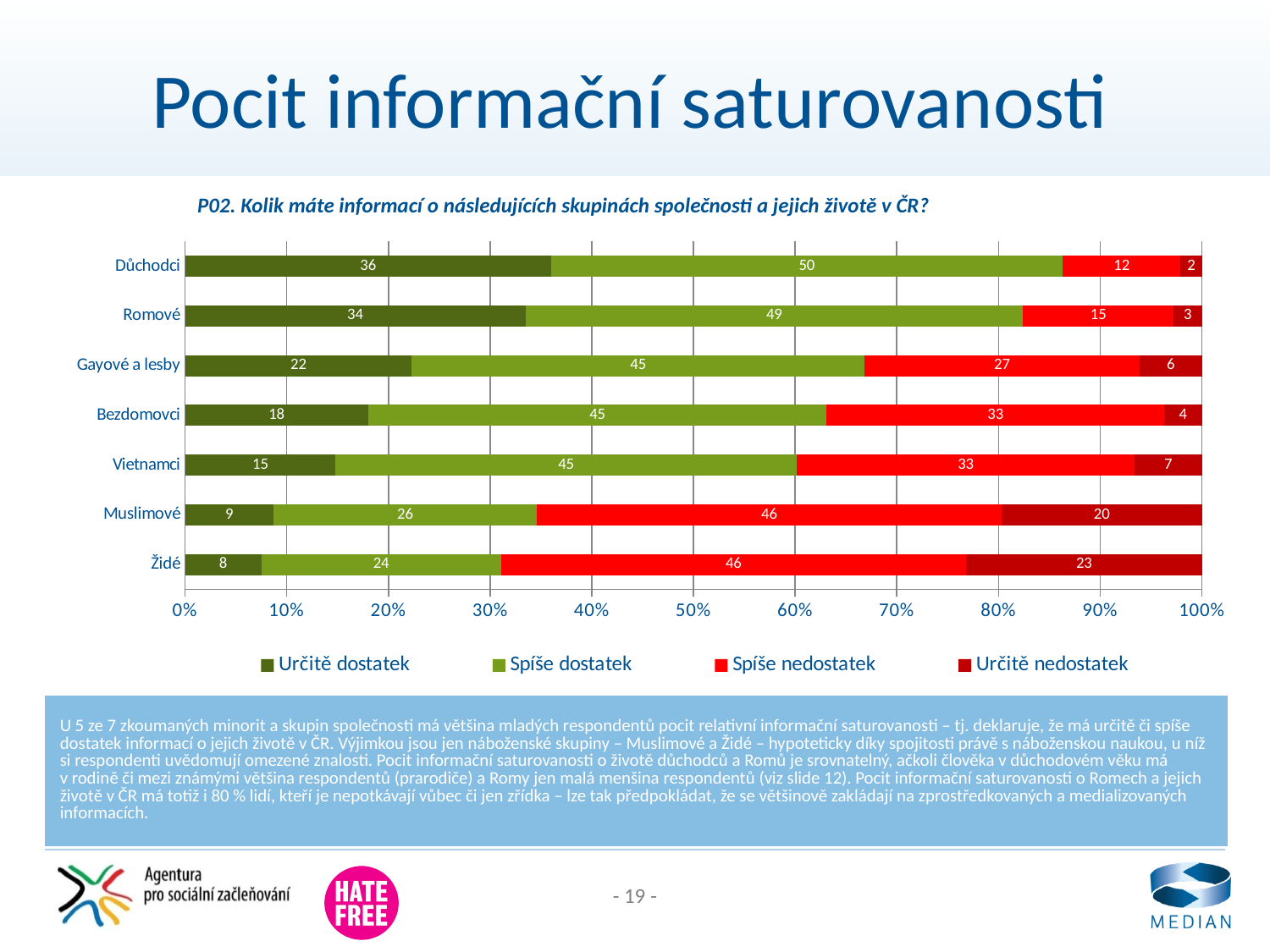
What is the value of 'Určitě dostatek' for Důchodci? 36 What is the value of 'Spíše nedostatek' for Muslimové? 46 Which group has the lowest value for 'Určitě dostatek'? Židé Which group has the highest value for 'Určitě dostatek'? Důchodci What type of chart is shown on the slide? stacked bar chart How many groups (categories) are listed on the vertical axis of the chart? 7 Which is larger: the 'Spíše nedostatek' value for Gayové a lesby or for Romové? Gayové a lesby What is the difference between the 'Spíše dostatek' values for Důchodci and Židé? 26 What is the combined value of 'Určitě dostatek' and 'Spíše dostatek' for Vietnamci? 60 What is the value of 'Určitě nedostatek' for Židé? 23 How many series does the chart legend list? 4 Which legend entry is shown in dark red? Určitě nedostatek